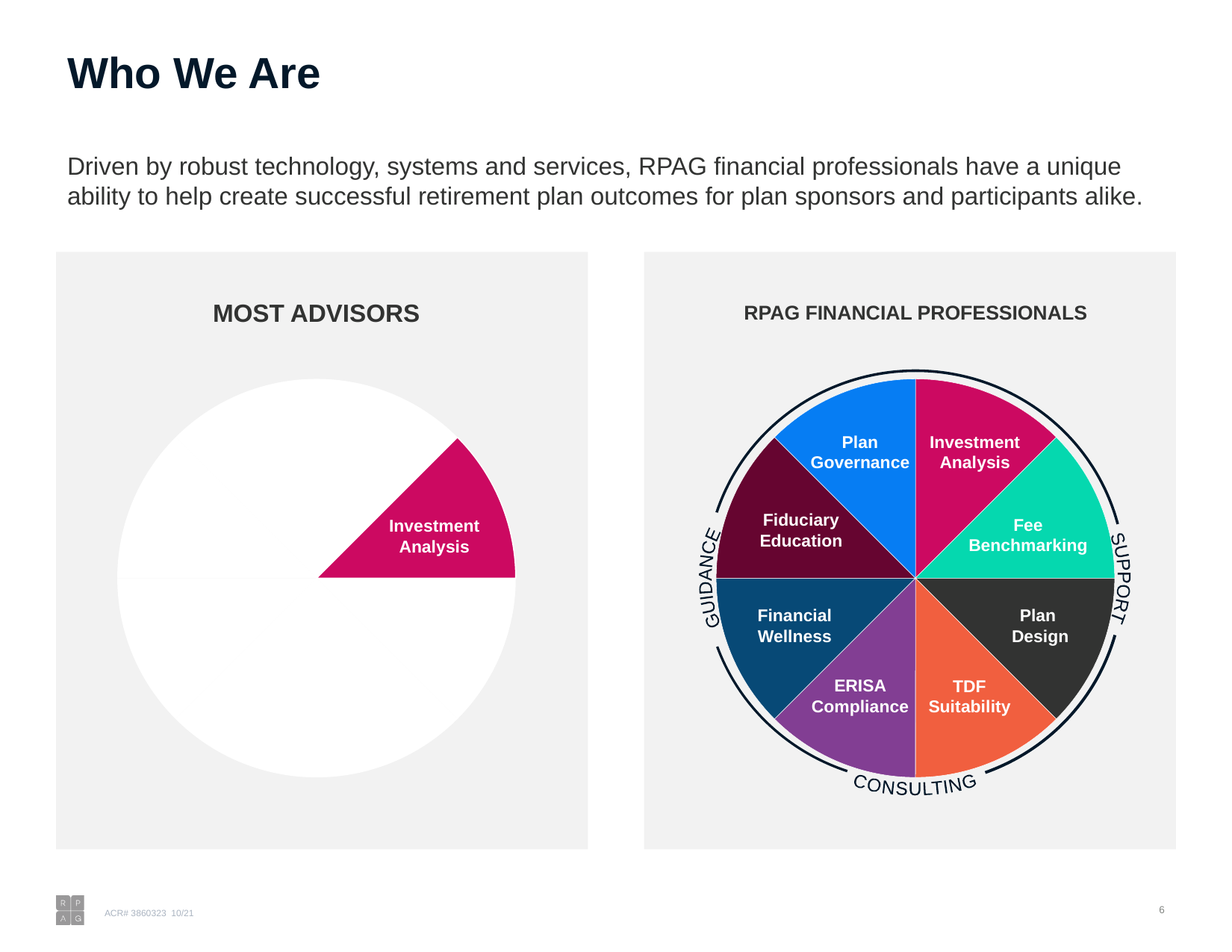
In the "MOST ADVISORS" pie chart, what is the label of the only coloured slice? Investment Analysis What is the title of the pie chart on the left side of the slide? MOST ADVISORS In the "RPAG FINANCIAL PROFESSIONALS" pie chart, which slice is labelled directly below "Fiduciary Education"? Financial Wellness In the "RPAG FINANCIAL PROFESSIONALS" pie chart, how many labelled slices are there? 8 What kind of chart is shown under the title "MOST ADVISORS"? Pie chart In the "MOST ADVISORS" pie chart, how many slices are labelled? 1 In the "RPAG FINANCIAL PROFESSIONALS" pie chart, which slice is coloured purple? ERISA Compliance What kind of chart is shown under the title "RPAG FINANCIAL PROFESSIONALS"? Pie chart In the "RPAG FINANCIAL PROFESSIONALS" pie chart, which slice is coloured orange? TDF Suitability In the "RPAG FINANCIAL PROFESSIONALS" pie chart, which slice is labelled between "Investment Analysis" and "Plan Design" going clockwise? Fee Benchmarking In the "RPAG FINANCIAL PROFESSIONALS" pie chart, which slice sits directly to the right of "Plan Governance"? Investment Analysis